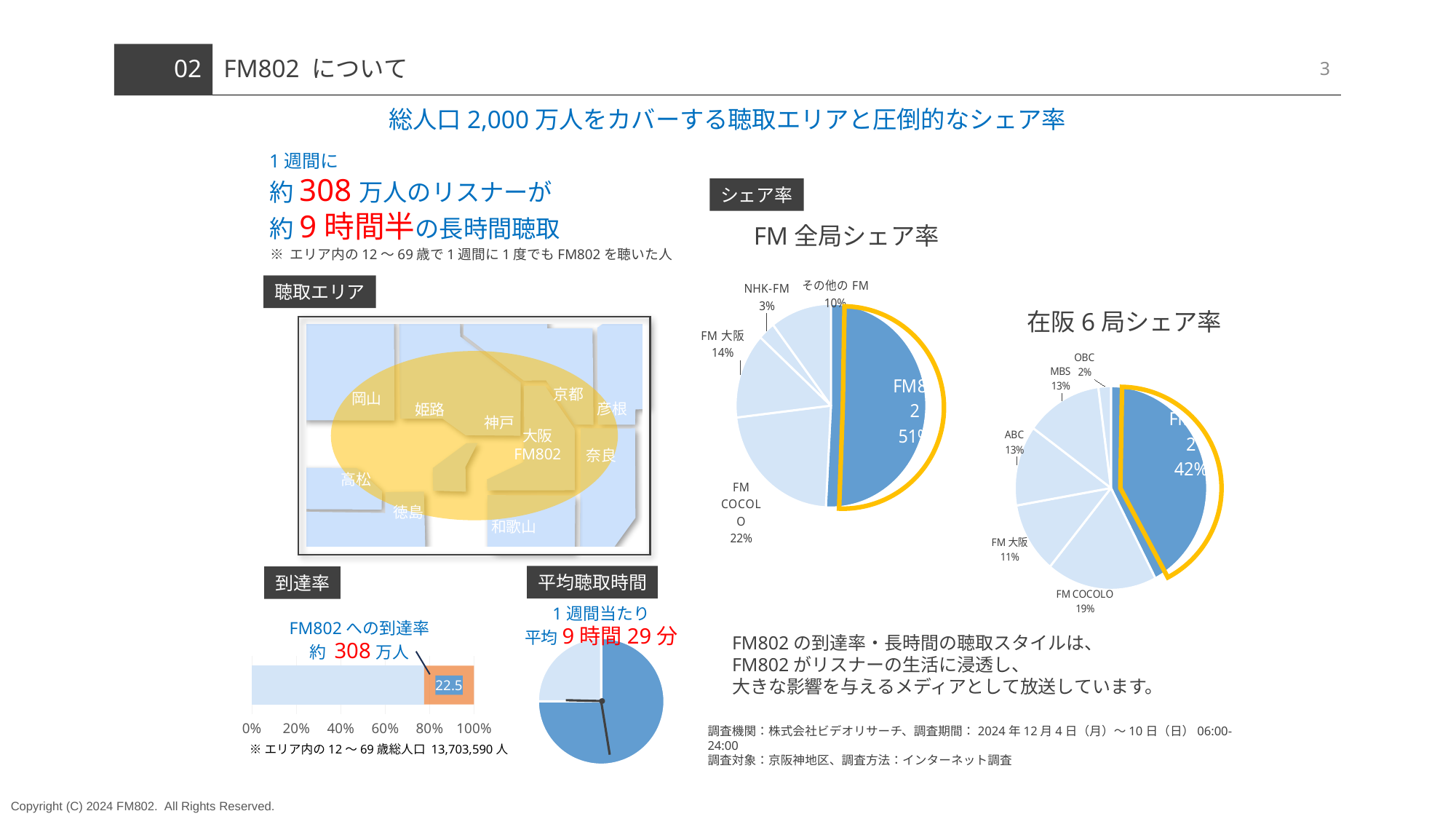
In the 'FM 全局シェア率' pie chart, what share does FM COCOLO have? 22% In the 'FM 全局シェア率' pie chart, which station has the smallest share? NHK-FM In the '在阪 6 局シェア率' pie chart, which station has the largest share? FM802 In the '在阪 6 局シェア率' pie chart, which is larger, the share of FM COCOLO or the share of FM 大阪? FM COCOLO In the 'FM 全局シェア率' pie chart, what share does FM802 have? 51% In the '在阪 6 局シェア率' pie chart, what share does FM802 have? 42% In the '在阪 6 局シェア率' pie chart, what is the difference between the FM COCOLO share and the ABC share? 6% In the 'FM802 への到達率' bar chart at the bottom left, what value is printed on the highlighted bar segment? 22.5 In the '在阪 6 局シェア率' pie chart, what share does OBC have? 2% In the 'FM 全局シェア率' pie chart, how many slices are there? 5 In the 'FM 全局シェア率' pie chart, what is the difference between the FM802 share and the FM 大阪 share? 37% What kind of chart is the 'FM 全局シェア率' chart? Pie chart